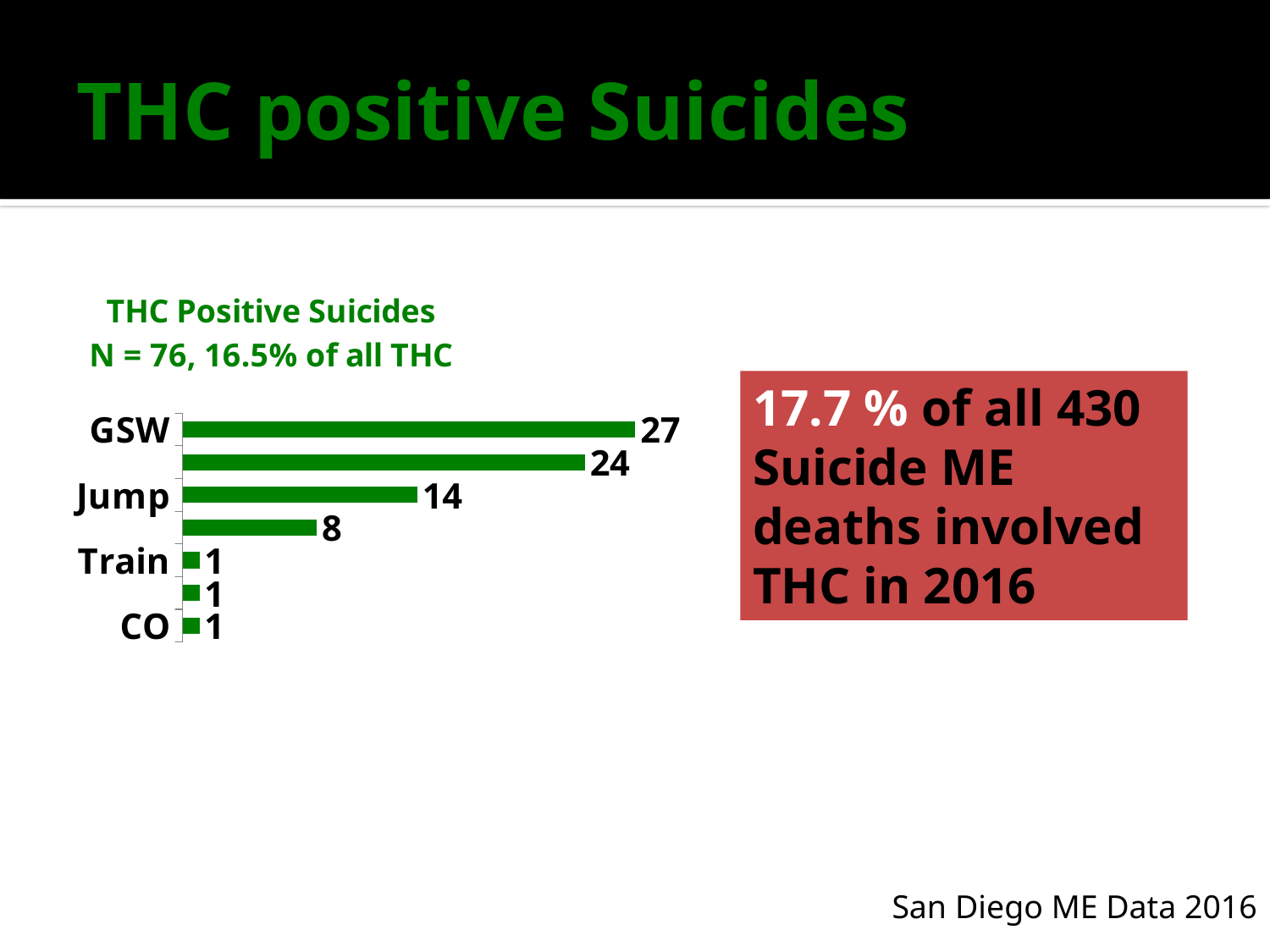
Which is larger, the value for GSW or the value for Jump? GSW What is the value for Jump? 14 How many bars are plotted in the chart? 7 Which is larger, the value for Jump or the value for CO? Jump What is the value for Train? 1 What is the title of the chart? THC Positive Suicides N = 76, 16.5% of all THC What is the value for CO? 1 What kind of chart is shown on the slide? bar chart What colour are the bars in the chart? green Which category has the highest value? GSW What is the difference between the values for GSW and Jump? 13 What is the value for GSW? 27